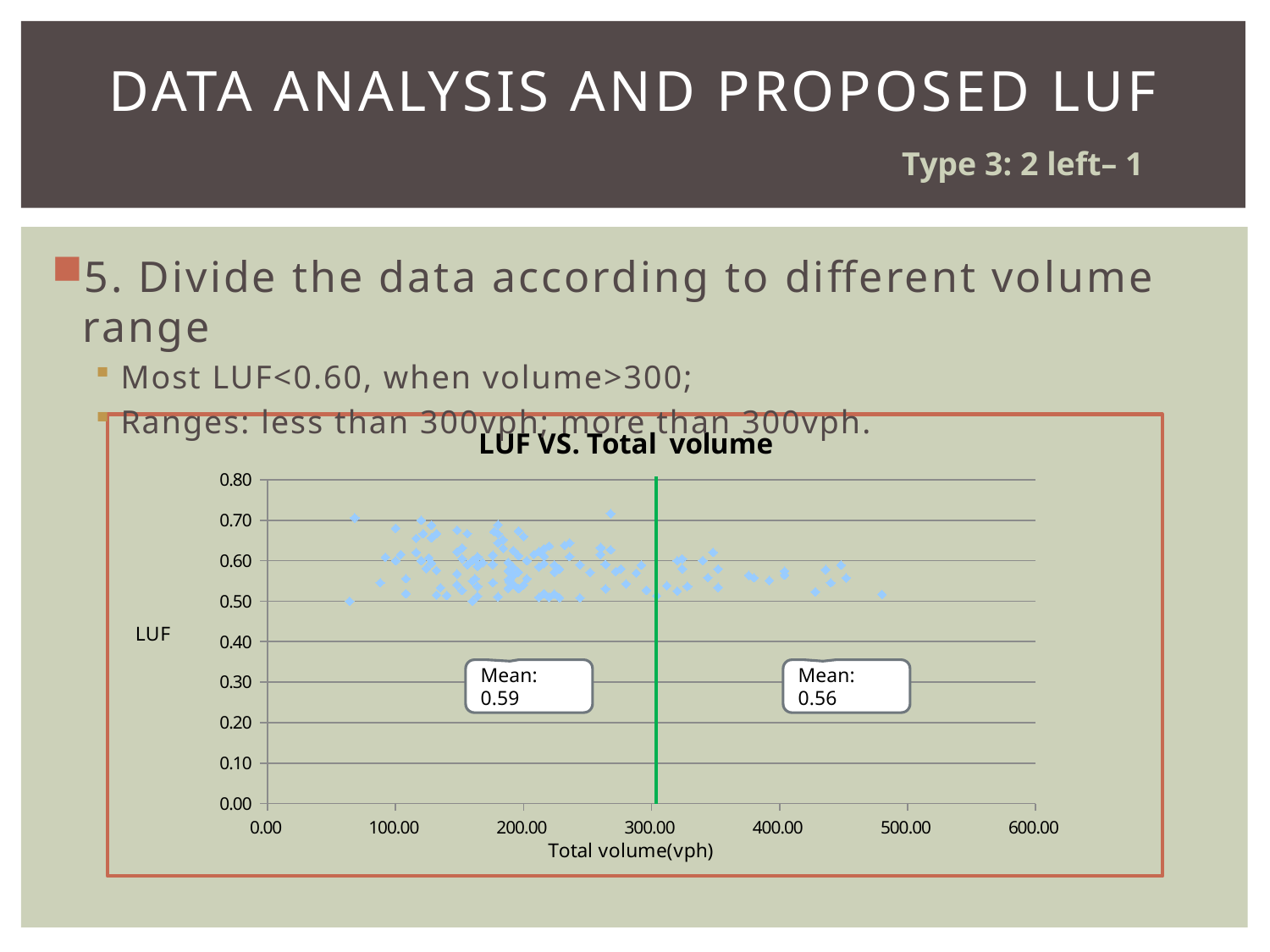
What is the highest tick value shown on the x axis? 600.00 Which annotated mean is larger: the one for volumes below 300 vph or the one for volumes above 300 vph? below 300 vph What is the difference between the two annotated mean LUF values? 0.03 What kind of chart is shown on the slide? scatter chart Are all the plotted LUF values greater or less than 0.80? less What mean LUF value is annotated for the data left of the vertical line (volume below 300 vph)? 0.59 Do the plotted LUF values show a strong rising trend as total volume increases along the x axis? no Is the annotated mean for volumes above 300 vph greater or less than 0.60? less What is the title of the chart? LUF VS. Total volume What is the label of the x axis of the chart? Total volume(vph) Are the plotted LUF values greater or less than 0.40? greater What mean LUF value is annotated for the data right of the vertical line (volume above 300 vph)? 0.56